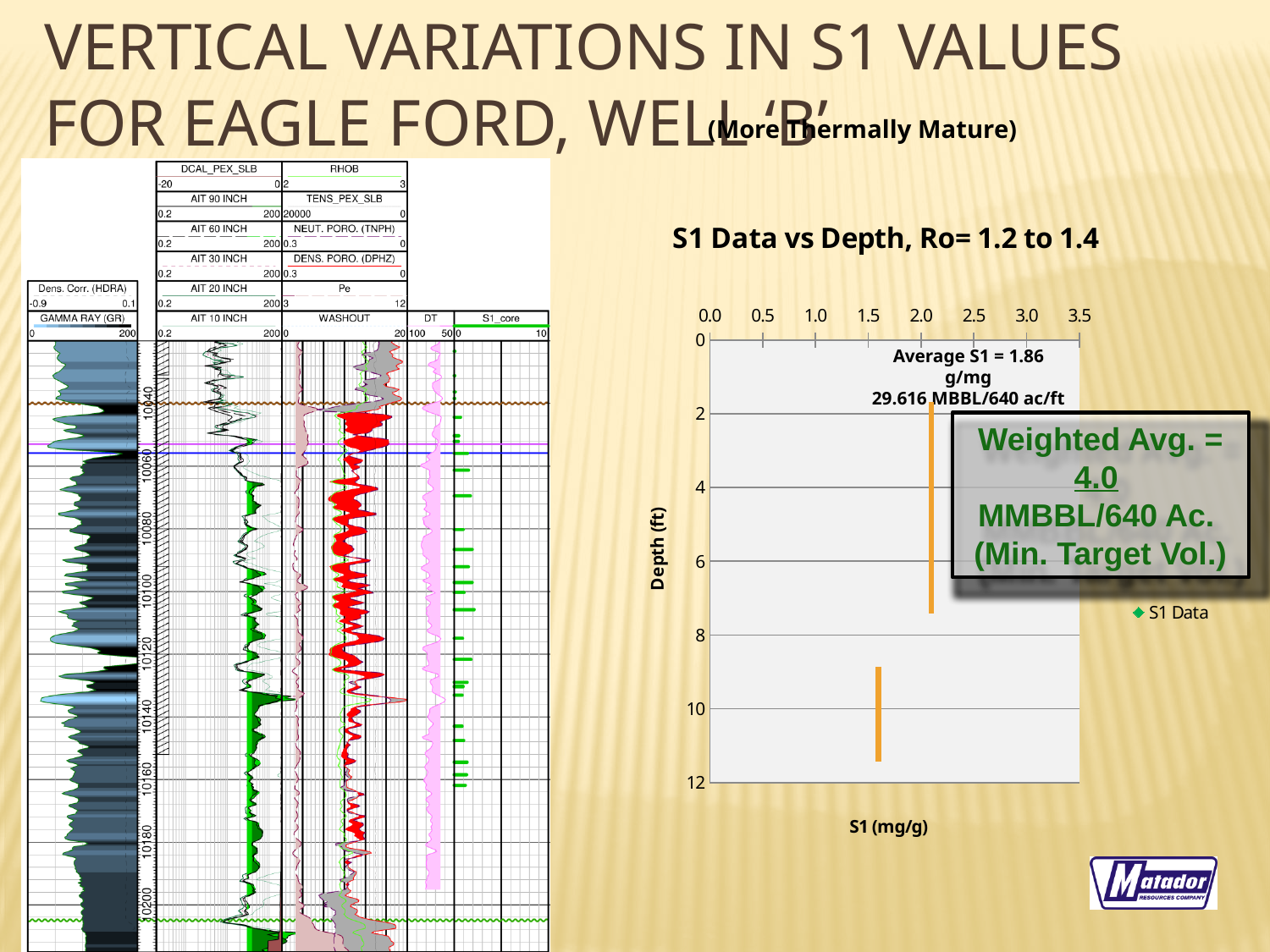
In the 'S1 Data vs Depth' chart, which orange data bar has the larger S1 value, the upper one or the lower one? the upper one In the 'S1 Data vs Depth' chart, what is the name of the series shown in the legend? S1 Data What is the title of the chart on the right side of the slide? S1 Data vs Depth, Ro= 1.2 to 1.4 In the 'S1 Data vs Depth' chart, what value in MBBL/640 ac/ft is printed in the annotation? 29.616 MBBL/640 ac/ft In the 'S1 Data vs Depth' chart, what average S1 value is stated in the annotation? 1.86 g/mg In the 'S1 Data vs Depth' chart, what kind of chart is used to plot the data? scatter chart In the 'S1 Data vs Depth' chart, what is the maximum value shown on the S1 (mg/g) axis? 3.5 In the 'S1 Data vs Depth' chart, what is the maximum value shown on the Depth (ft) axis? 12 In the 'S1 Data vs Depth' chart, is the S1 value of the lower orange data bar (around depth 9 to 11 ft) greater or less than 2.0? less In the 'S1 Data vs Depth' chart, is the S1 value of the upper orange data bar (around depth 2 to 7 ft) greater or less than 1.5? greater In the 'S1 Data vs Depth' chart, how many series does the legend list? 1 In the 'S1 Data vs Depth' chart, what weighted average in MMBBL/640 Ac. is stated in the boxed annotation? 4.0